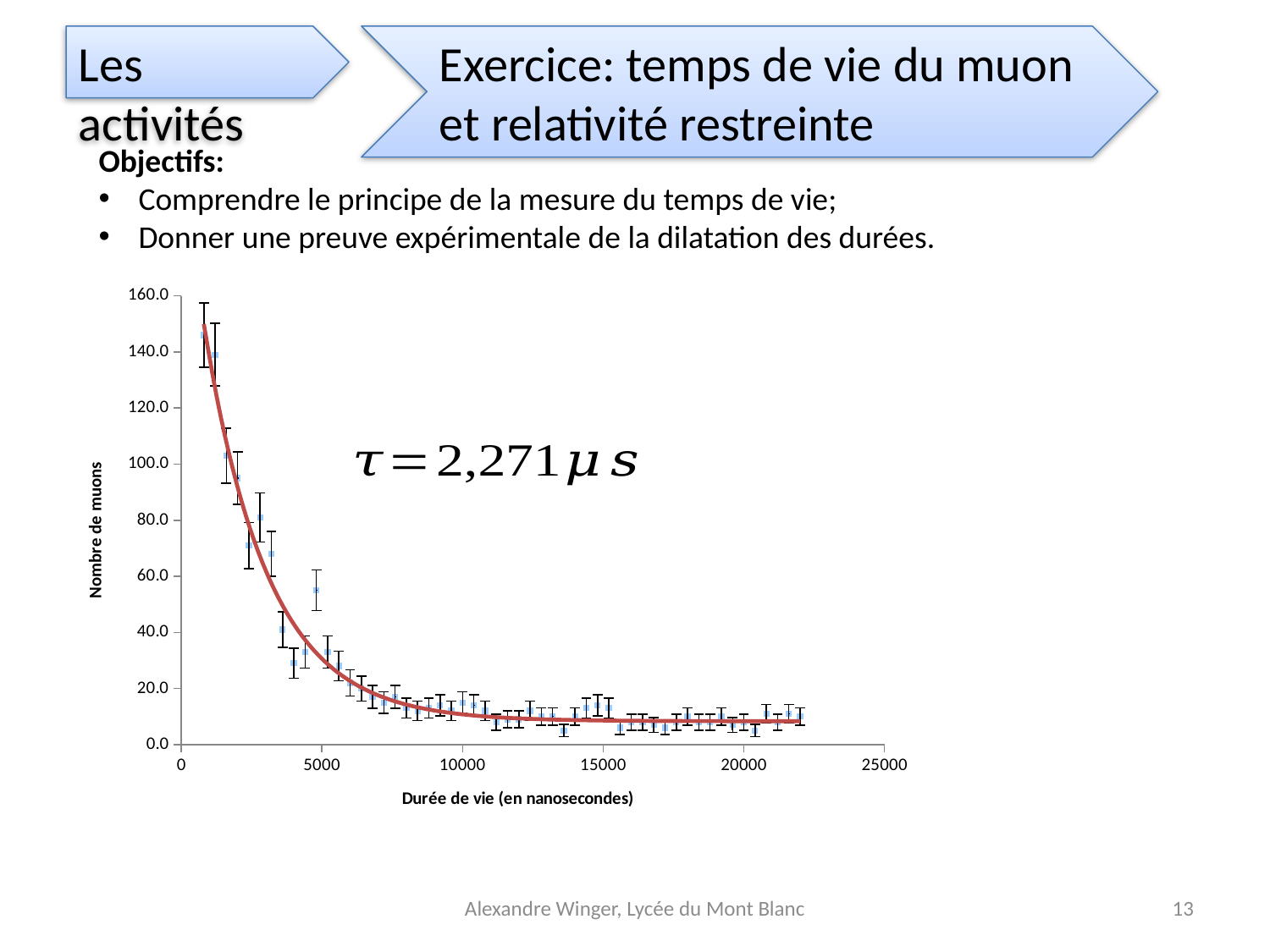
What is the title of the x axis of the chart? Durée de vie (en nanosecondes) Is the number of muons at about 10000 ns greater or less than 40? less Is the number of muons at about 20000 ns greater or less than 20? less What is the title of the y axis of the chart? Nombre de muons Is the number of muons at about 2000 ns greater or less than 80? greater What is the highest value shown on the y axis of the chart? 160.0 Do the values of 'Nombre de muons' rise or fall as 'Durée de vie' increases along the x axis? fall Which has more muons: the data point near 1000 ns or the data point near 15000 ns? the data point near 1000 ns What kind of chart is shown on the slide? scatter plot with error bars and a fitted curve